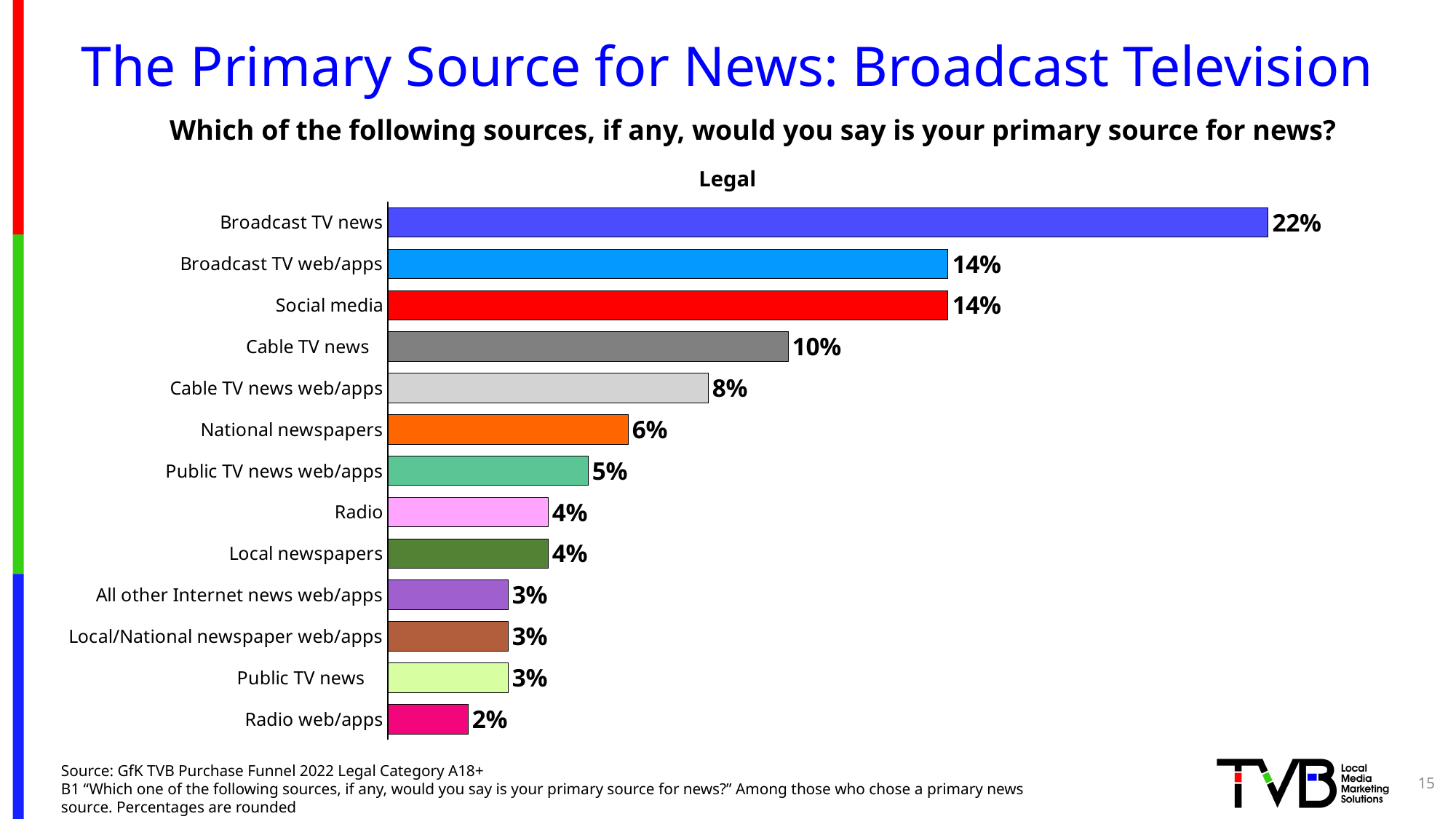
What percentage of respondents named Broadcast TV news as their primary source for news? 22% Which source has the highest percentage in the chart? Broadcast TV news What kind of chart is shown on the slide? Bar chart What is the difference in percentage points between Social media and National newspapers? 8 What is the difference in percentage points between Broadcast TV news and Cable TV news? 12 What is the title printed directly above the chart? Legal How many news sources (categories) are shown in the chart? 13 Which source has the lowest percentage in the chart? Radio web/apps What is the value shown for Cable TV news web/apps? 8% What is the value shown for Public TV news web/apps? 5% What colour is the bar for Social media? Red Which is larger, the value for Cable TV news or the value for National newspapers? Cable TV news